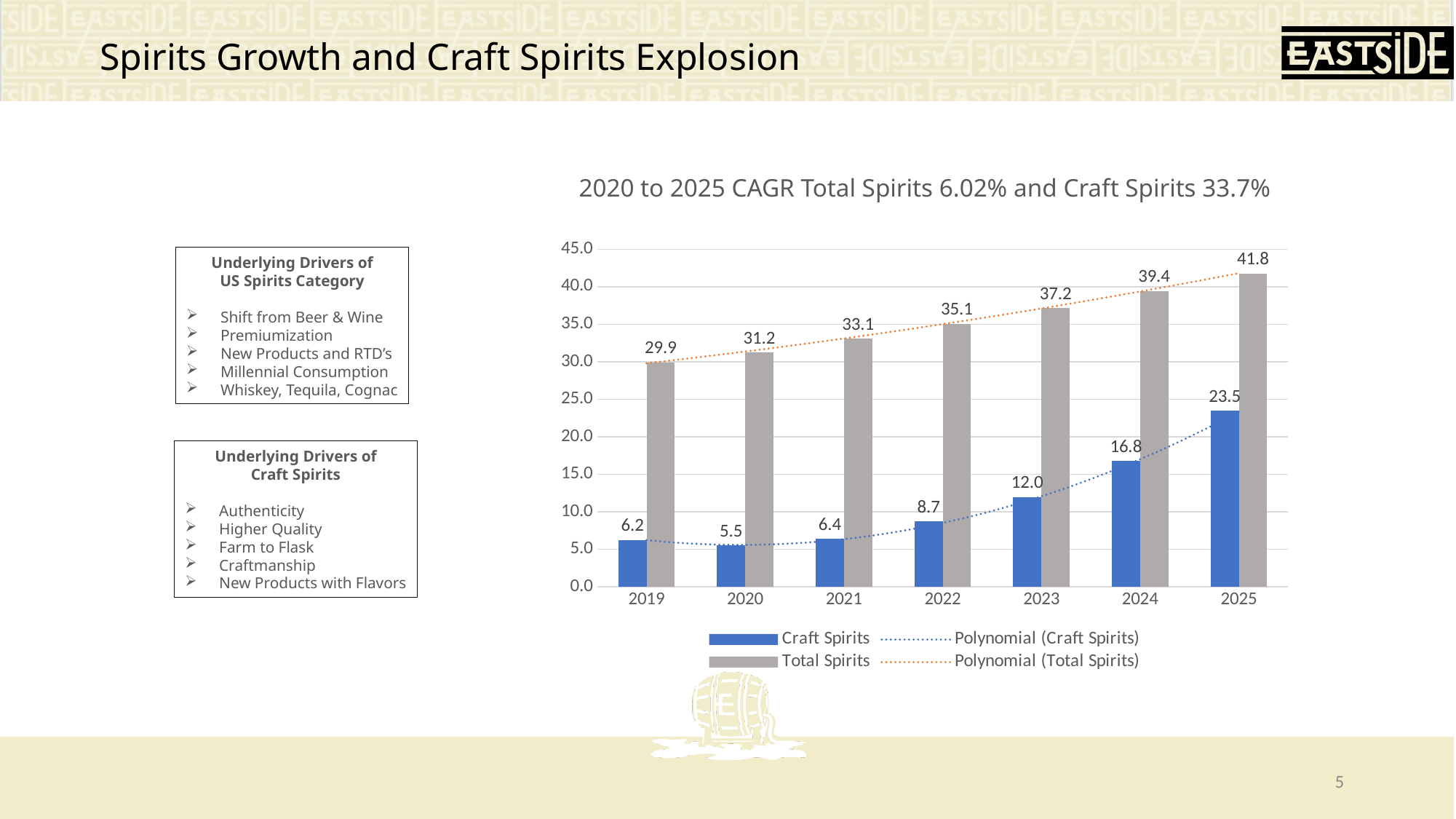
What kind of chart is shown? Bar chart What is the value for Total Spirits in 2021? 33.1 What is the difference between Total Spirits and Craft Spirits in 2025? 18.3 How many entries does the legend list? 4 Which is larger, the Craft Spirits value in 2019 or in 2021? 2021 What is the value for Craft Spirits in 2023? 12.0 Which year has the lowest Craft Spirits value? 2020 Which year has the highest Total Spirits value? 2025 Do the Total Spirits values rise or fall from 2019 to 2025? Rise What is the difference between the Craft Spirits values for 2024 and 2023? 4.8 How many years are shown on the x axis? 7 What is the value for Craft Spirits in 2025? 23.5